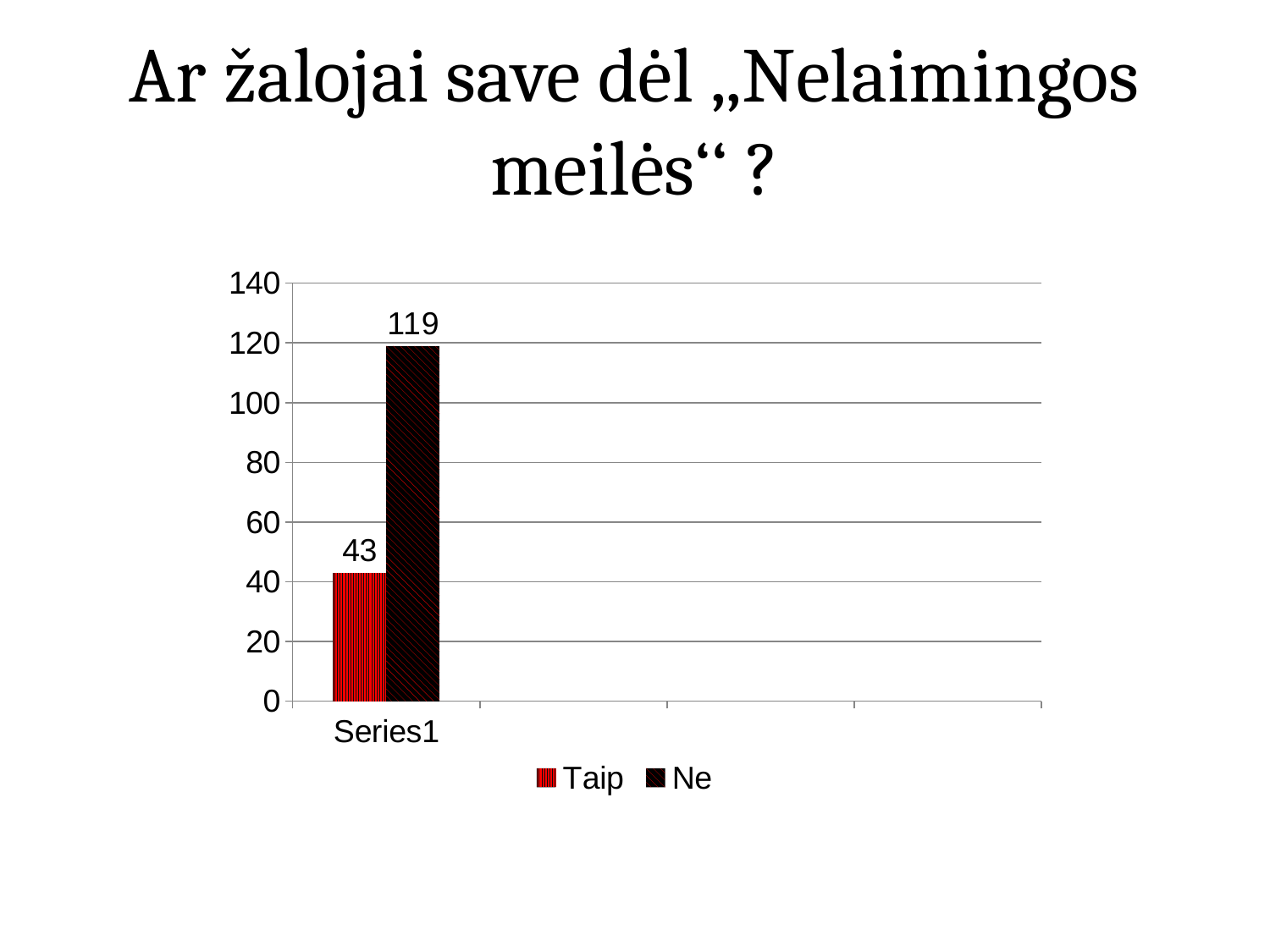
What is the value for Ne? 119 Is the value for Taip greater or less than 60? less How many series does the legend list? 2 Is the value for Ne greater or less than 100? greater What is the difference between the values for Ne and Taip? 76 Which series has the lower value? Taip What is the highest value shown on the y axis? 140 What is the category label shown on the x axis? Series1 Which series has the higher value, Taip or Ne? Ne What is the value for Taip? 43 What kind of chart is shown on the slide? bar chart What is the total of the Taip and Ne values? 162